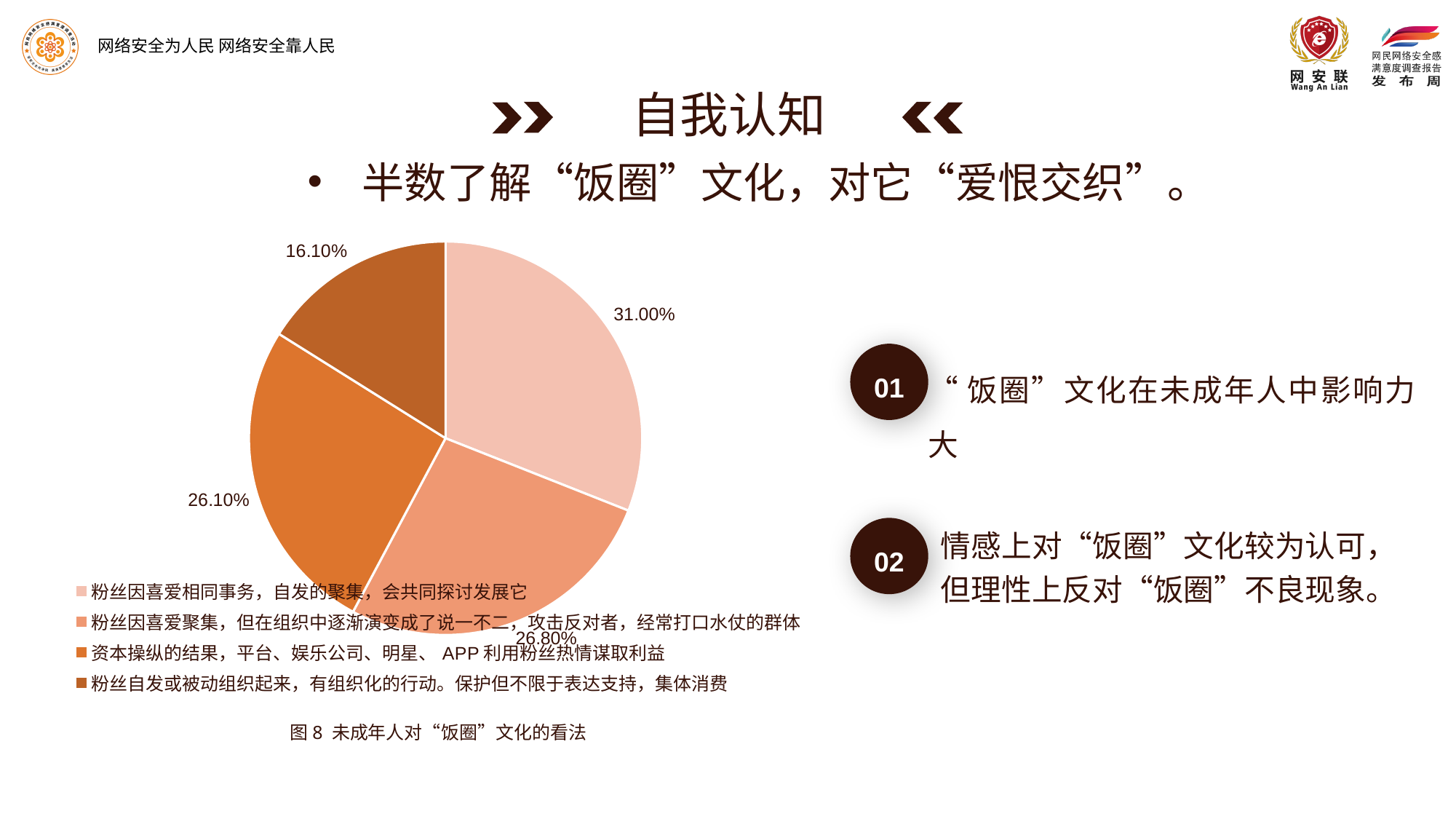
What percentage is shown for "粉丝自发或被动组织起来，有组织化的行动。保护但不限于表达支持，集体消费"? 16.10% What kind of chart is shown on the slide? Pie chart Which category has the smallest share of the pie? 粉丝自发或被动组织起来，有组织化的行动。保护但不限于表达支持，集体消费 What percentage of the pie is labelled for the category "粉丝因喜爱相同事务，自发的聚集，会共同探讨发展它"? 31.00% How many slices does the pie chart have? 4 What percentage is shown for "资本操纵的结果，平台、娱乐公司、明星、 APP 利用粉丝热情谋取利益"? 26.10% What is the caption of the pie chart? 图 8 未成年人对“饭圈”文化的看法 How many entries does the legend of the pie chart list? 4 What is the difference in percentage points between the largest slice (31.00%) and the smallest slice (16.10%)? 14.90% Which category has the largest share of the pie? 粉丝因喜爱相同事务，自发的聚集，会共同探讨发展它 What percentage is shown for "粉丝因喜爱聚集，但在组织中逐渐演变成了说一不二，攻击反对者，经常打口水仗的群体"? 26.80% Which is larger: the share for "粉丝因喜爱聚集，但在组织中逐渐演变成了说一不二，攻击反对者，经常打口水仗的群体" or the share for "资本操纵的结果，平台、娱乐公司、明星、 APP 利用粉丝热情谋取利益"? 粉丝因喜爱聚集，但在组织中逐渐演变成了说一不二，攻击反对者，经常打口水仗的群体